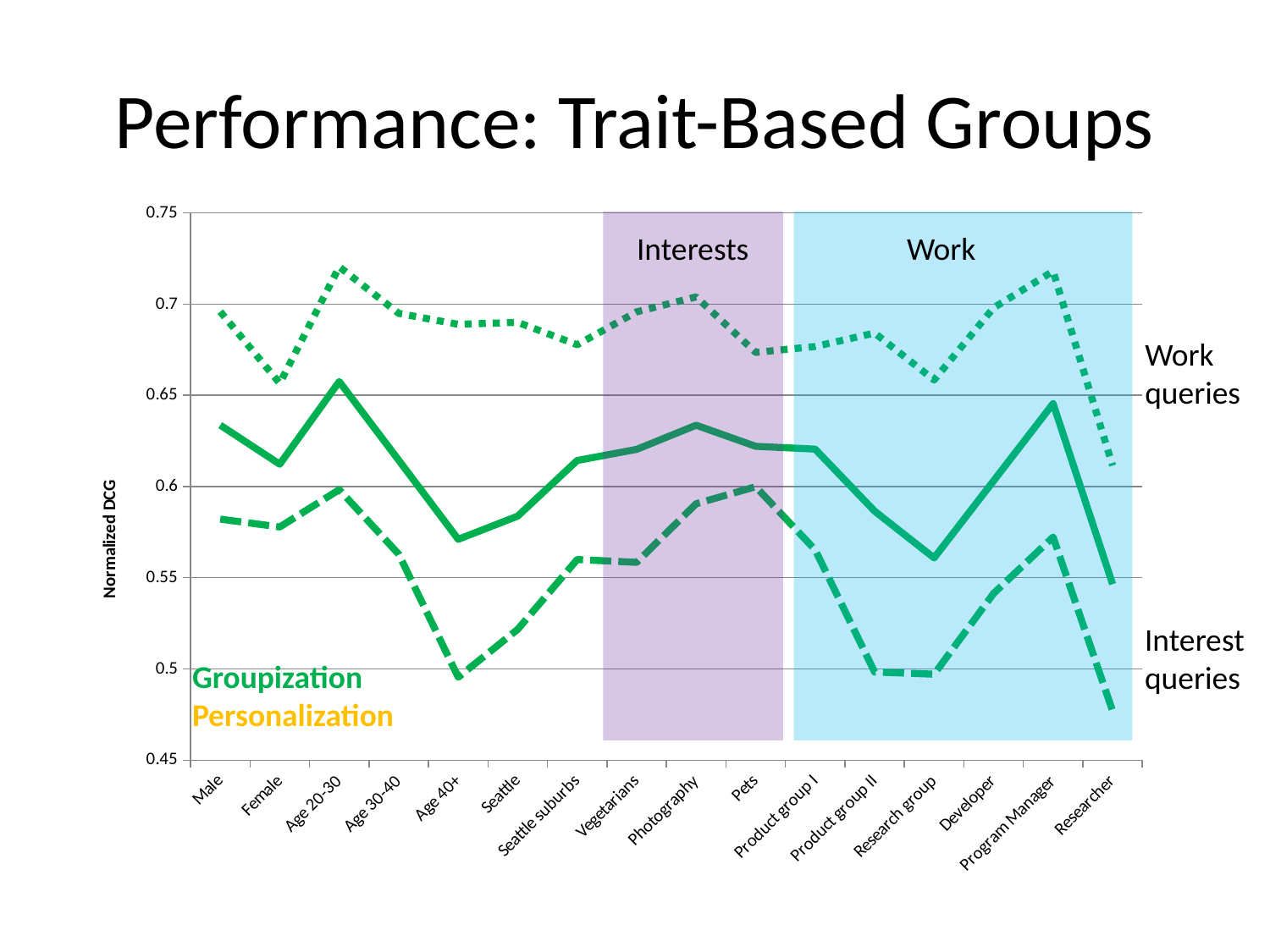
How many categories are shown along the x axis of the chart? 16 Is the value of the solid line for Program Manager greater or less than 0.6? greater Is the value of the dotted 'Work queries' line for Age 20-30 greater or less than 0.7? greater For which category does the dashed 'Interest queries' line reach its lowest value? Researcher Is the value of the dashed 'Interest queries' line for Age 40+ greater or less than 0.5? less What kind of chart is shown on the slide? line chart Does the dashed 'Interest queries' line rise or fall from Product group I to Product group II? fall For the Male category, which line has the higher value: the dotted 'Work queries' line or the dashed 'Interest queries' line? Work queries What is the label on the y axis of the chart? Normalized DCG What is the title of the slide containing the chart? Performance: Trait-Based Groups